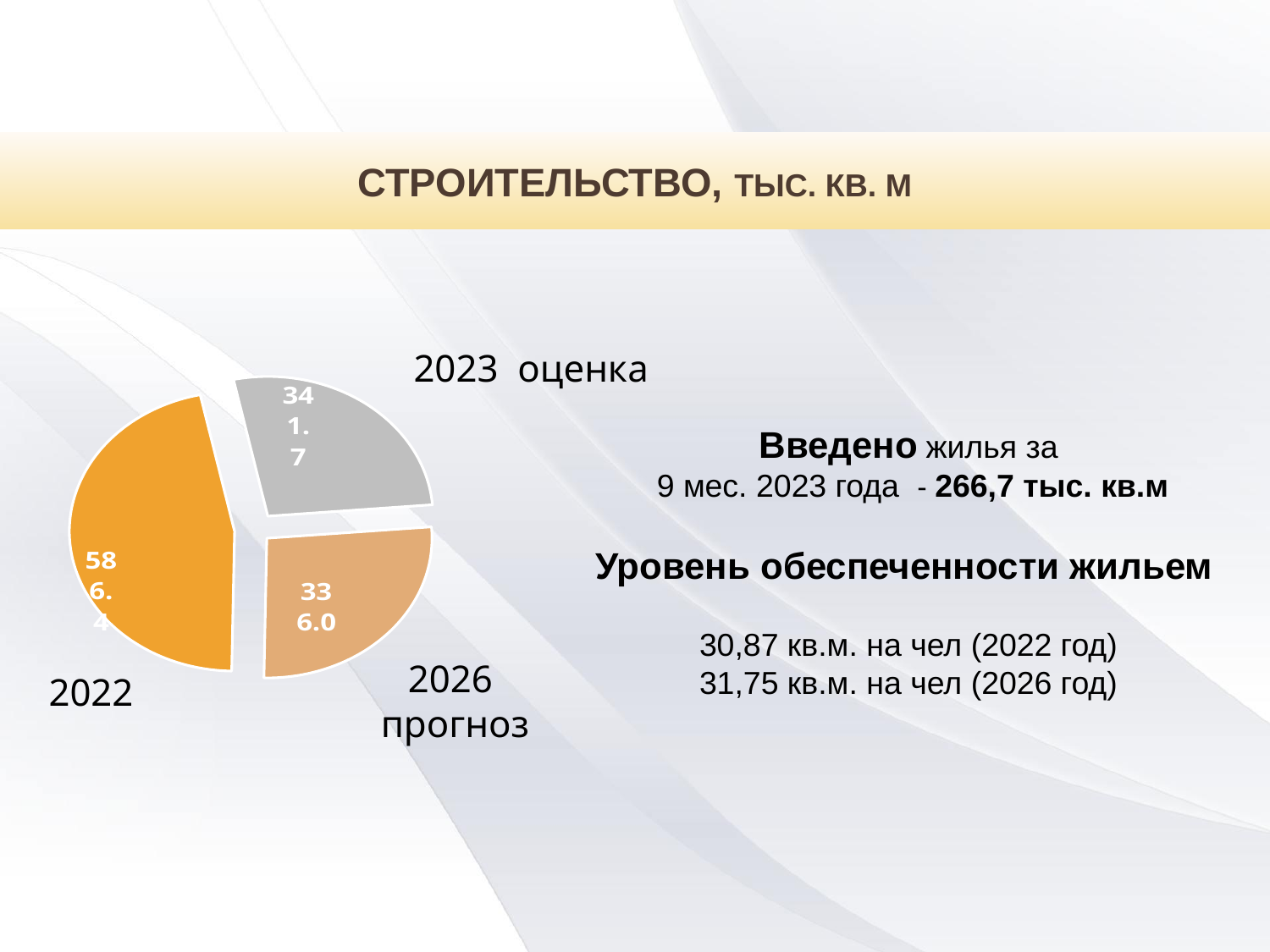
Which slice of the pie chart has the largest value? 2022 What is the value of the 2022 slice in the pie chart? 586.4 What colour is the 2023 оценка slice in the pie chart? gray How many slices does the pie chart have? 3 Which is larger in the pie chart: the 2023 оценка value or the 2026 прогноз value? 2023 оценка What is the value of the 2026 прогноз slice in the pie chart? 336.0 What is the title of the slide containing the pie chart? СТРОИТЕЛЬСТВО, тыс. кв. м What is the difference between the 2023 оценка value and the 2026 прогноз value in the pie chart? 5.7 Which slice of the pie chart has the smallest value? 2026 прогноз What is the value of the 2023 оценка slice in the pie chart? 341.7 What is the difference between the 2022 value and the 2023 оценка value in the pie chart? 244.7 What kind of chart is shown on the slide? pie chart